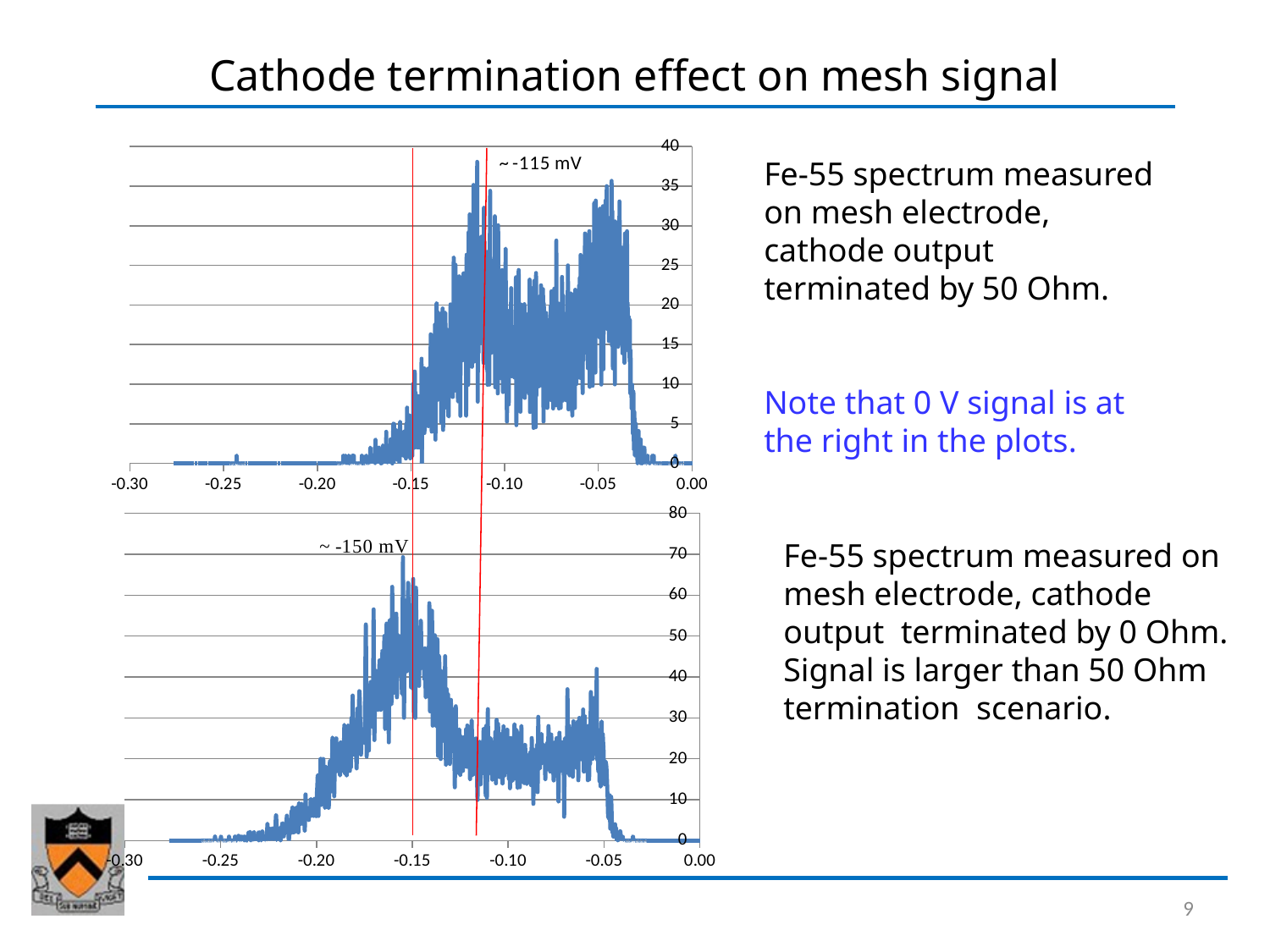
What voltage annotation is written next to the red line in the top chart? ~ -115 mV In the bottom chart, is the value at -0.10 on the horizontal axis greater or less than 40? less How many charts are shown on the slide? 2 What kind of chart is the top chart on the slide? line chart Which chart reaches a higher peak count, the top chart or the bottom chart? the bottom chart In the bottom chart, is the maximum peak height greater or less than 60? greater In the top chart, is the value at -0.25 on the horizontal axis greater or less than 5? less What voltage annotation is written near the main peak in the bottom chart? ~ -150 mV In the bottom chart, what is the highest value shown on the vertical axis? 80 What is the leftmost value shown on the horizontal axis of the top chart? -0.30 In the top chart, what is the highest value shown on the vertical axis? 40